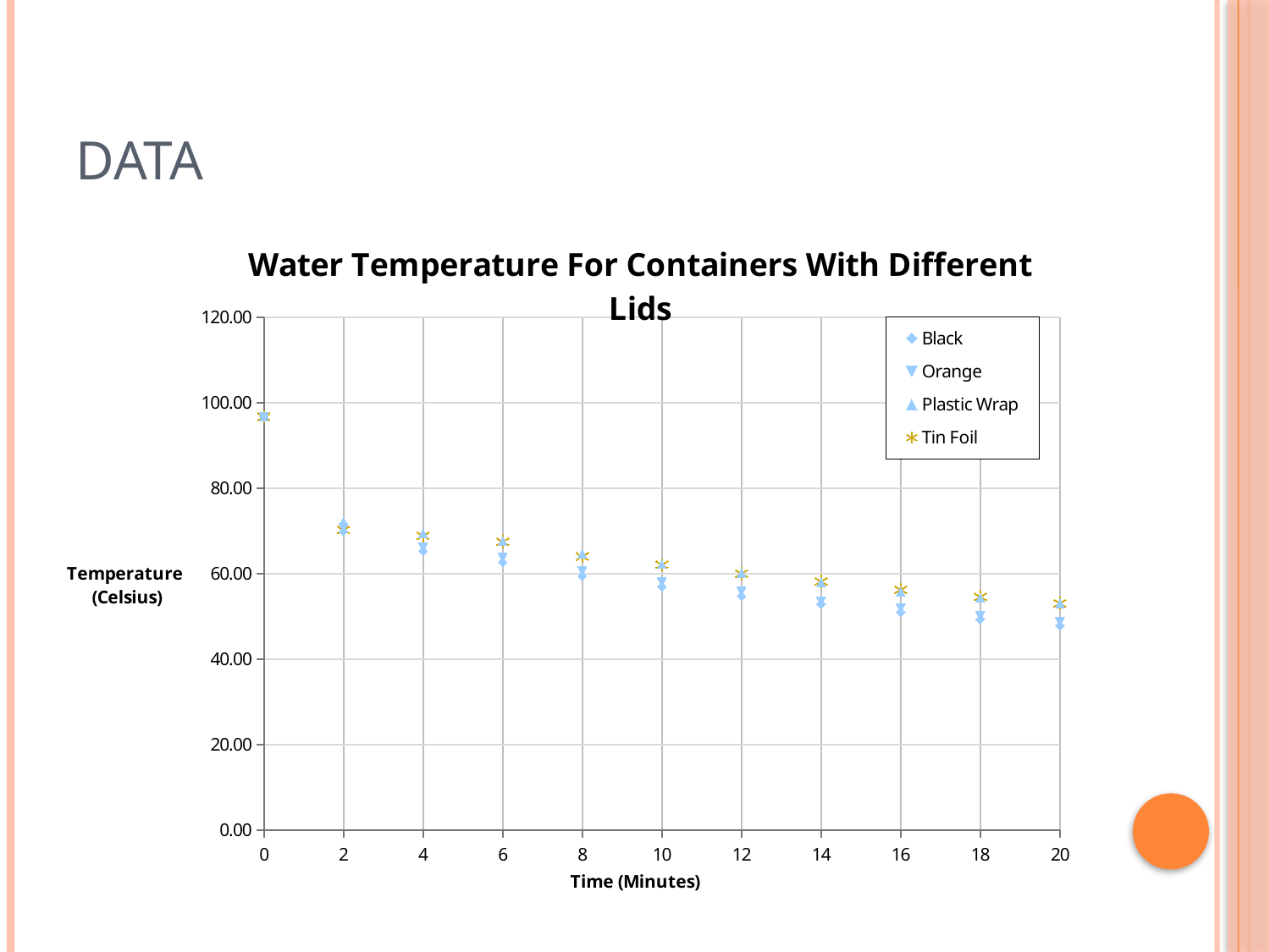
How many series does the legend list? 4 For the Tin Foil series, which is larger: the value at 0 minutes or the value at 20 minutes? 0 minutes Is the Tin Foil value at 20 minutes greater or less than 40.00? greater Is the Orange value at 20 minutes greater or less than 60.00? less What kind of chart is shown on the slide? Scatter chart How many time points are plotted for each series along the x axis? 11 Which series are listed in the legend? Black, Orange, Plastic Wrap, Tin Foil Do the temperatures rise or fall as time increases along the x axis? Fall Is the value for all series at 0 minutes greater or less than 80.00? greater At 20 minutes, which is larger: the Tin Foil value or the Orange value? Tin Foil What is the title of the chart? Water Temperature For Containers With Different Lids